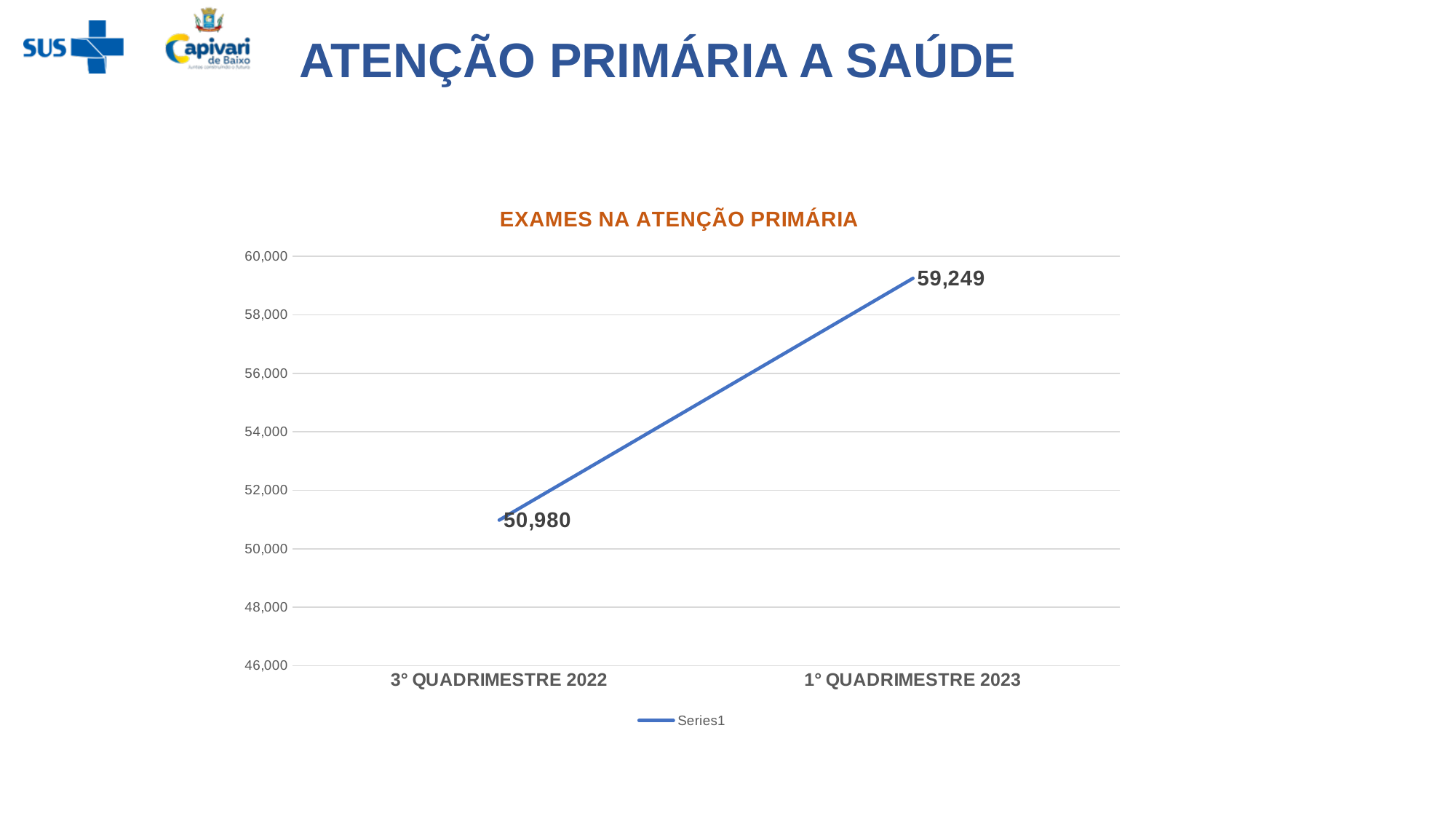
Which period has the highest value? 1° QUADRIMESTRE 2023 What is the value for 1° QUADRIMESTRE 2023? 59,249 What kind of chart is shown? line chart Is the value for 1° QUADRIMESTRE 2023 greater or less than 58,000? greater How many series does the legend list? 1 Do the values rise or fall from 3° QUADRIMESTRE 2022 to 1° QUADRIMESTRE 2023? rise Is the value for 3° QUADRIMESTRE 2022 greater or less than 52,000? less Which period has the lowest value? 3° QUADRIMESTRE 2022 What is the value for 3° QUADRIMESTRE 2022? 50,980 How many data points are plotted on the chart? 2 Which is larger, the value for 3° QUADRIMESTRE 2022 or the value for 1° QUADRIMESTRE 2023? 1° QUADRIMESTRE 2023 What is the difference between the values for 1° QUADRIMESTRE 2023 and 3° QUADRIMESTRE 2022? 8,269